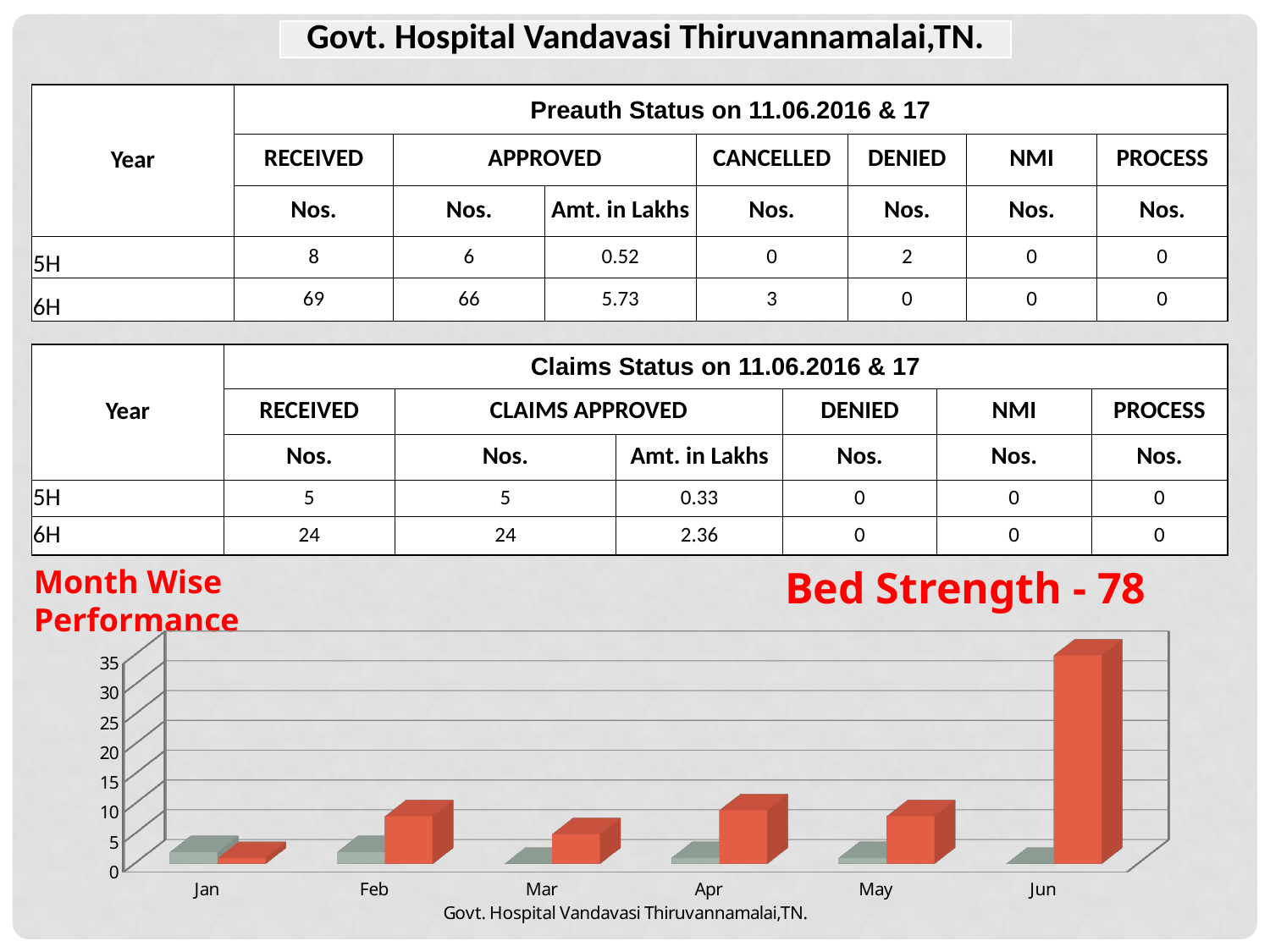
What kind of chart is shown at the bottom of the slide? bar chart In the bar chart, is the red bar for Jun or for Feb taller? Jun Is the red bar for Apr in the bar chart greater or less than 5? greater What is the highest value shown on the vertical axis of the bar chart? 35 In the bar chart, which month has the tallest red bar? Jun Is the red bar for Feb in the bar chart greater or less than 10? less Is the red bar for Jun in the bar chart greater or less than 30? greater In the bar chart, is the red bar for Apr or for Mar taller? Apr How many months are shown on the x axis of the bar chart? 6 What text appears below the x axis of the bar chart? Govt. Hospital Vandavasi Thiruvannamalai,TN. In the bar chart, which month has the shortest red bar? Jan